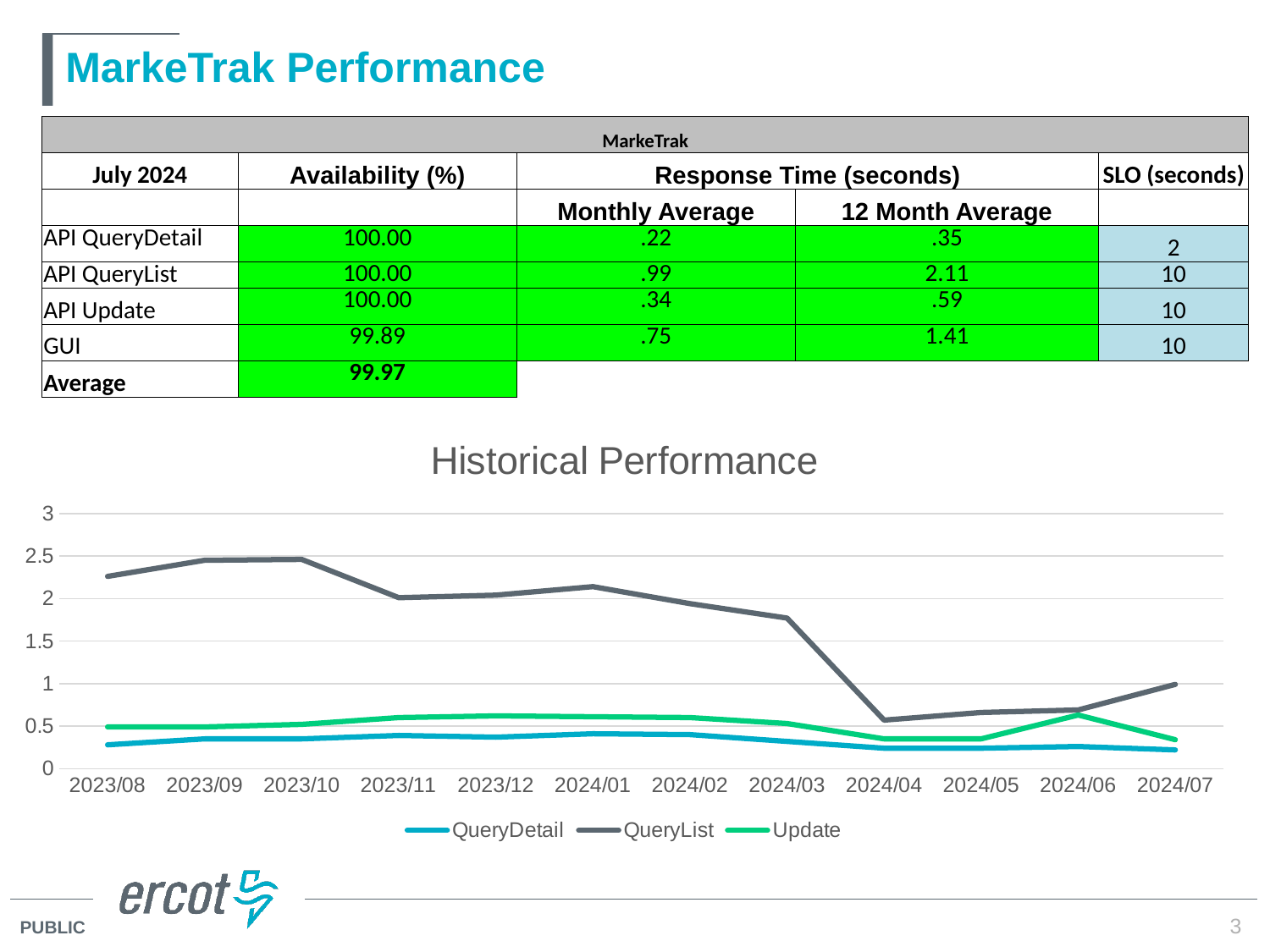
In the Historical Performance chart, is the QueryList value for 2024/04 greater or less than 1? less What is the title of the chart on the slide? Historical Performance What kind of chart is the Historical Performance chart? line chart How many months are plotted along the x axis of the Historical Performance chart? 12 Which series in the Historical Performance chart has the highest values across the period? QueryList In the Historical Performance chart, is the Update value for 2024/06 greater or less than 0.5? greater In the Historical Performance chart, is the QueryList value for 2023/08 greater or less than 2? greater In the Historical Performance chart, which is larger at 2024/07: Update or QueryDetail? Update In the Historical Performance chart, does the QueryList series rise or fall from 2023/10 to 2024/04? fall Which series in the Historical Performance chart has the lowest values across the period? QueryDetail How many series does the legend of the Historical Performance chart list? 3